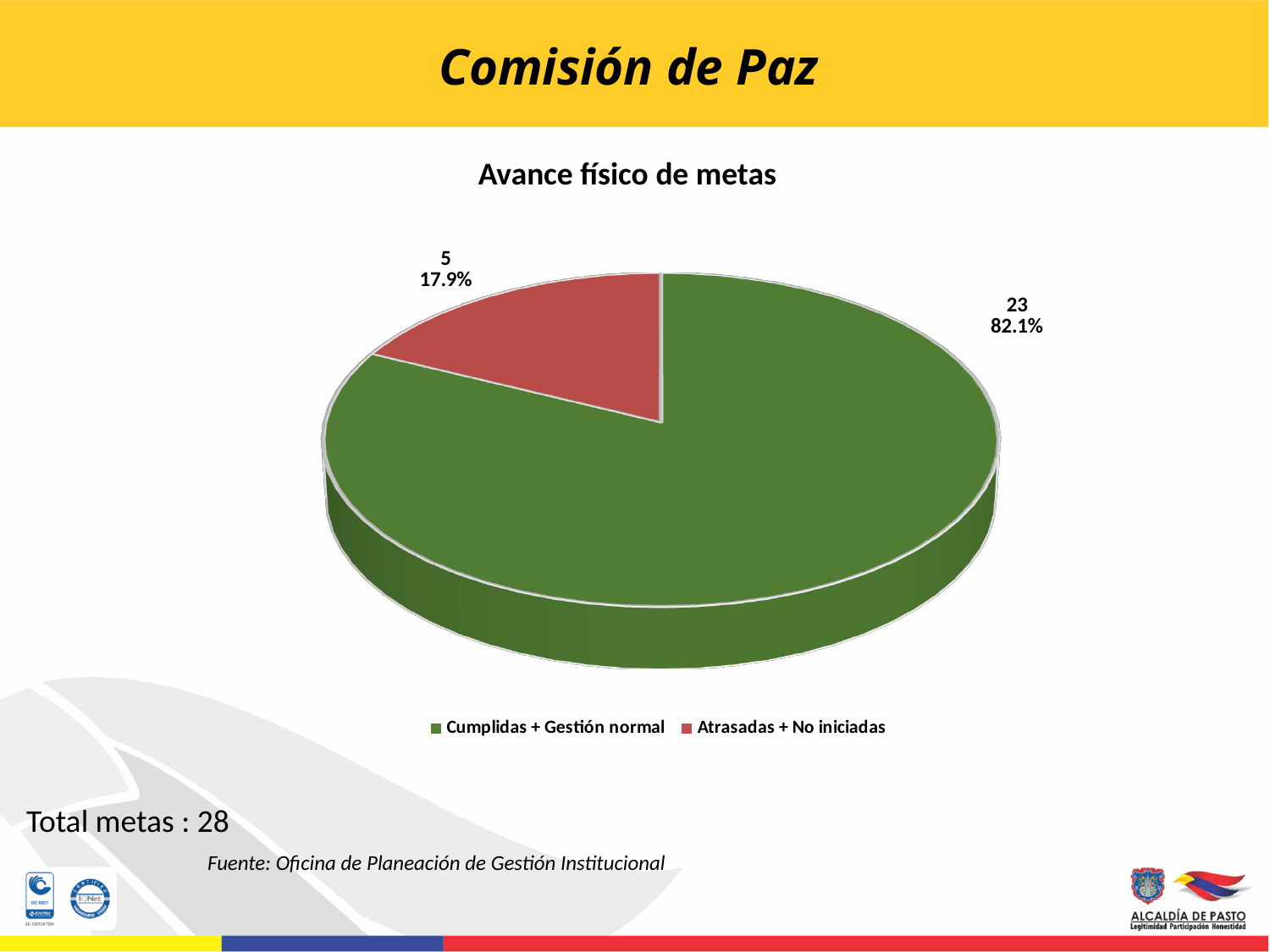
What is the difference between the values for Cumplidas + Gestión normal and Atrasadas + No iniciadas? 18 What is the title of the chart? Avance físico de metas How many entries does the legend list? 2 What kind of chart is shown on the slide? pie chart What is the value for Atrasadas + No iniciadas? 5 Which category has the largest slice? Cumplidas + Gestión normal What share of the pie does Atrasadas + No iniciadas represent? 17.9% Which colour represents Atrasadas + No iniciadas in the chart? red What share of the pie does Cumplidas + Gestión normal represent? 82.1% Which category has the smallest slice? Atrasadas + No iniciadas What is the value for Cumplidas + Gestión normal? 23 How many slices does the pie chart have? 2